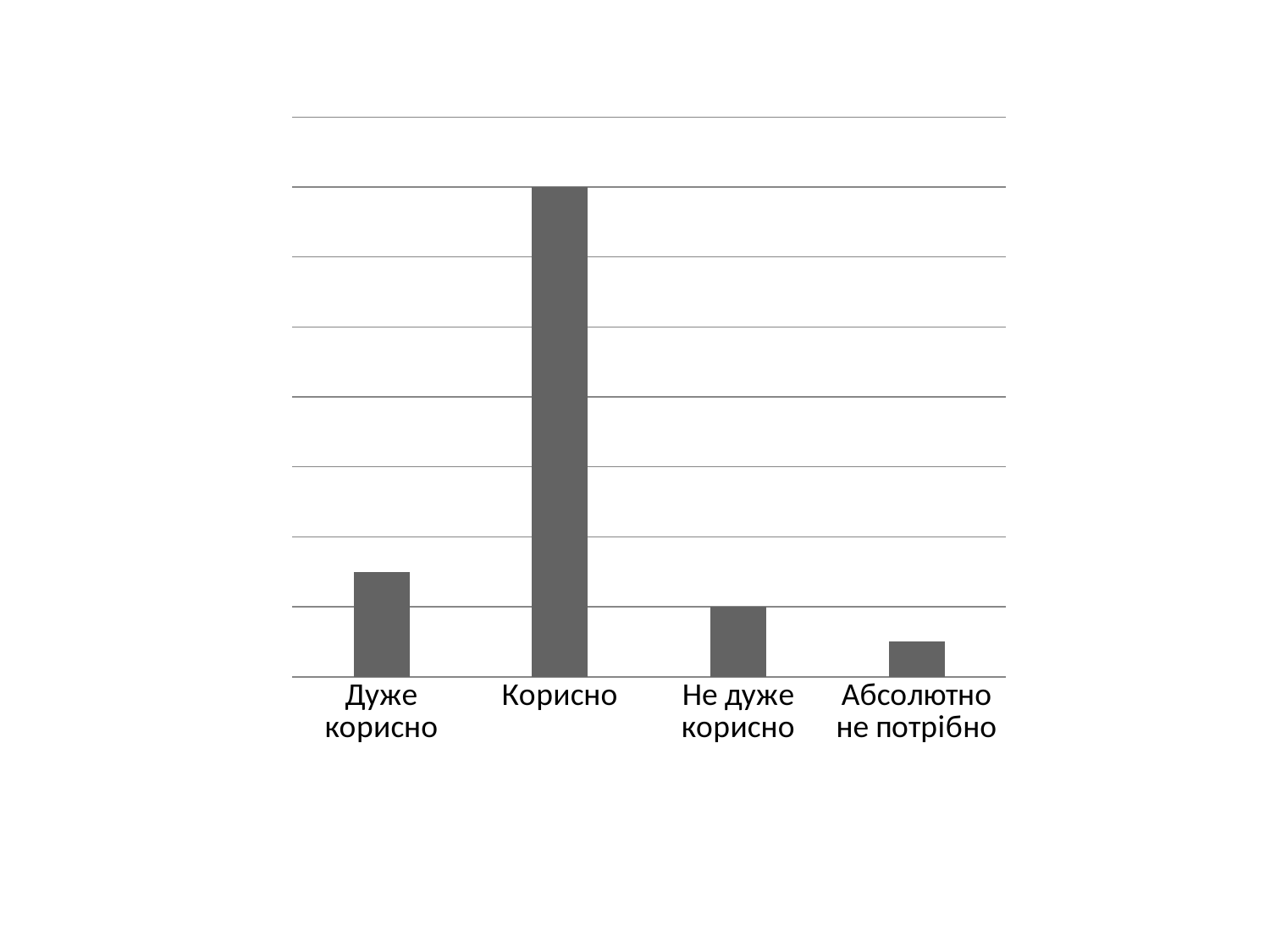
What is the label of the last category on the x axis? Абсолютно не потрібно Which category has the highest bar? Корисно Which is larger, the value for Не дуже корисно or the value for Абсолютно не потрібно? Не дуже корисно How many categories are plotted on the chart? 4 Which category has the lowest bar? Абсолютно не потрібно Which is larger, the value for Дуже корисно or the value for Не дуже корисно? Дуже корисно What is the label of the first category on the x axis? Дуже корисно Which is larger, the value for Корисно or the value for Дуже корисно? Корисно What kind of chart is shown on the slide? bar chart